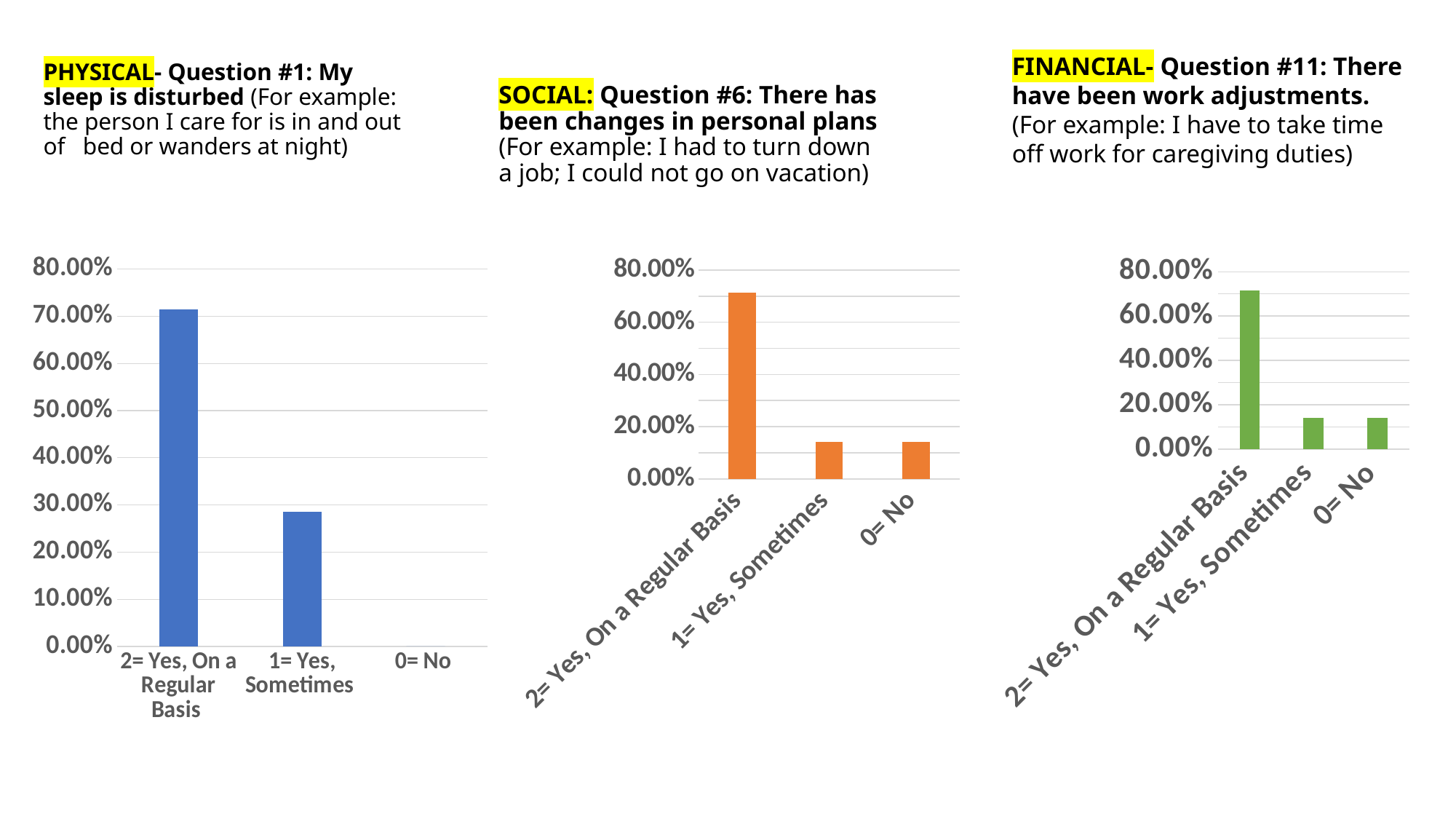
On the SOCIAL chart (middle), is the value for 2= Yes, On a Regular Basis greater or less than 60.00%? greater On the PHYSICAL chart (left), is the value for 1= Yes, Sometimes greater or less than 40.00%? less What type of chart is the SOCIAL chart (middle)? bar chart On the FINANCIAL chart (right), which category has the highest value? 2= Yes, On a Regular Basis On the PHYSICAL chart (left), which category has the highest value? 2= Yes, On a Regular Basis On the PHYSICAL chart (left), is the value for 2= Yes, On a Regular Basis greater or less than 60.00%? greater On the SOCIAL chart (middle), which category has the highest value? 2= Yes, On a Regular Basis On the PHYSICAL chart (left), which is larger: the value for 2= Yes, On a Regular Basis or the value for 1= Yes, Sometimes? 2= Yes, On a Regular Basis How many categories are shown on the FINANCIAL chart (right)? 3 On the PHYSICAL chart (left), which category has the lowest value? 0= No